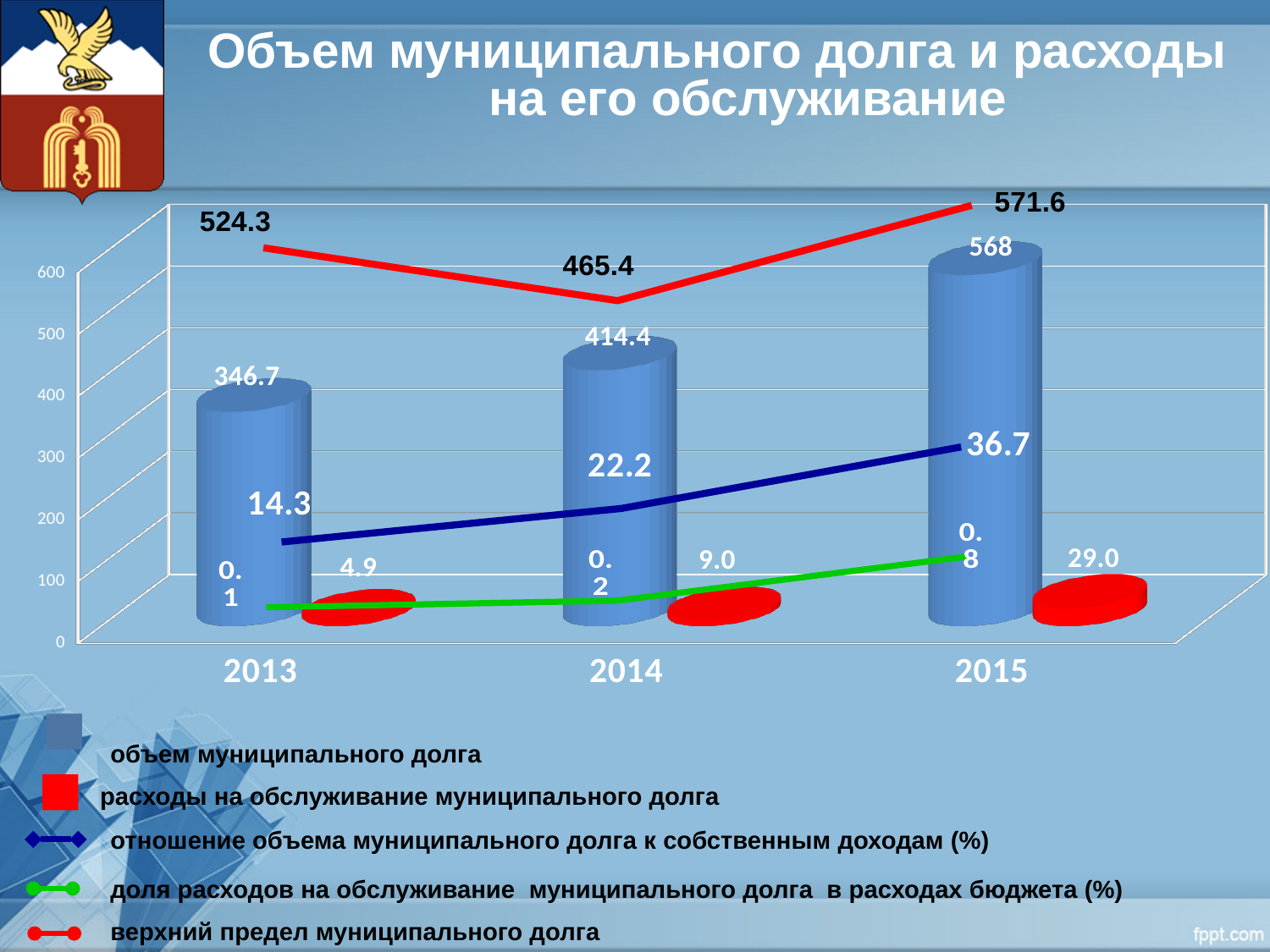
In which year is объем муниципального долга highest? 2015 What is the difference between объем муниципального долга in 2015 and in 2013? 221.3 What is the value of верхний предел муниципального долга for 2013? 524.3 How many years are shown on the x axis? 3 What is the value of объем муниципального долга for 2015? 568 What is the value of отношение объема муниципального долга к собственным доходам (%) for 2014? 22.2 Which is larger in 2014: объем муниципального долга or верхний предел муниципального долга? верхний предел муниципального долга Does доля расходов на обслуживание муниципального долга в расходах бюджета (%) rise or fall from 2013 to 2015? rise What colour is the line for верхний предел муниципального долга? red How many series does the legend list? 5 What is the value of расходы на обслуживание муниципального долга for 2014? 9.0 In which year is верхний предел муниципального долга lowest? 2014